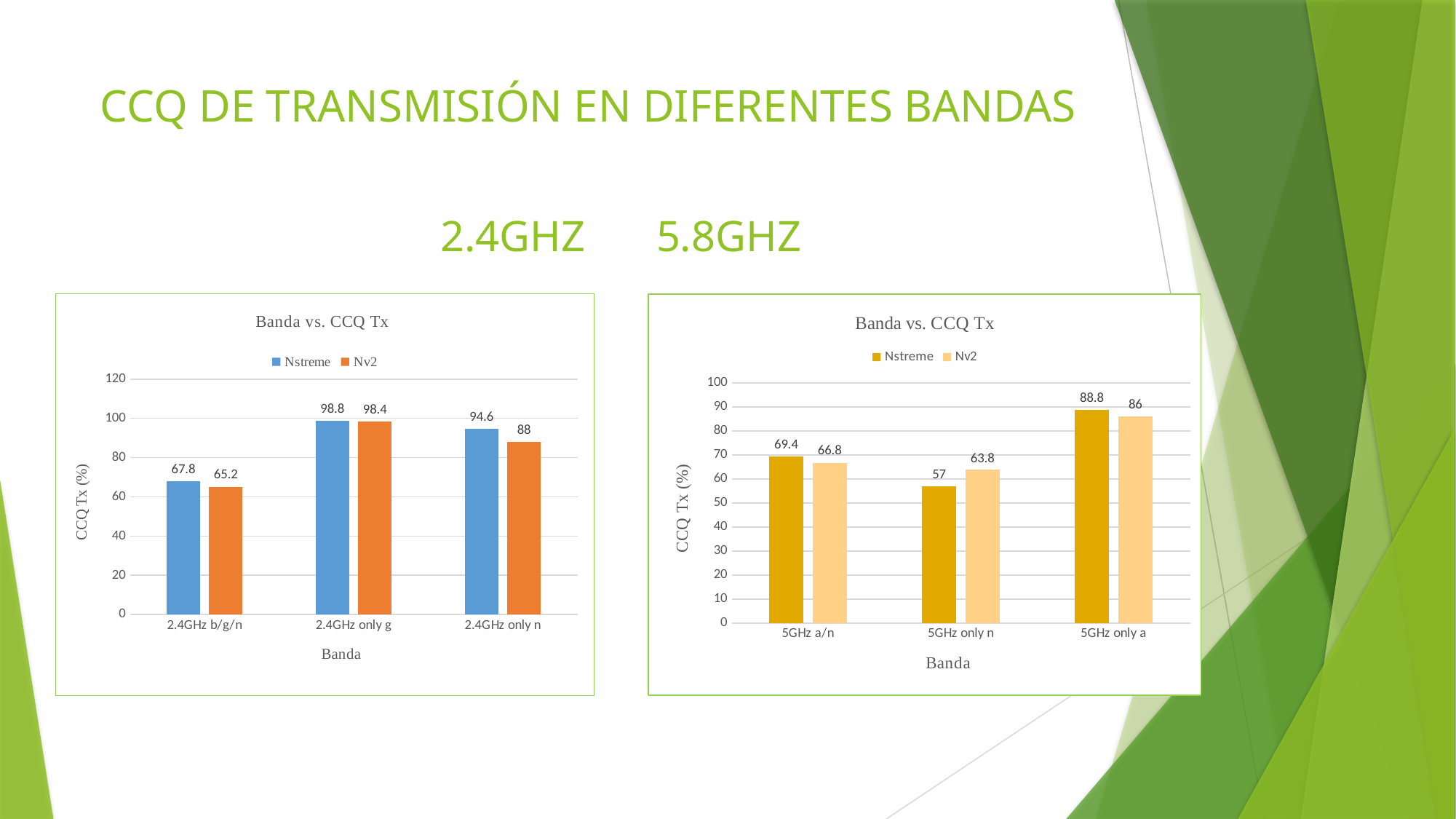
In the right chart (5.8GHz), which category has the highest Nstreme value? 5GHz only a What type of chart is the left chart (2.4GHz)? Bar chart In the left chart (2.4GHz), what is the difference between the Nstreme and Nv2 values for 2.4GHz only n? 6.6 In the right chart (5.8GHz), what is the difference between the Nstreme values for 5GHz only a and 5GHz only n? 31.8 In the left chart (2.4GHz), what is the Nstreme value for 2.4GHz only g? 98.8 In the right chart (5.8GHz), how many series does the legend list? 2 In the left chart (2.4GHz), what is the Nv2 value for 2.4GHz b/g/n? 65.2 In the right chart (5.8GHz), what is the Nv2 value for 5GHz only n? 63.8 In the right chart (5.8GHz), which is larger for 5GHz only n: Nstreme or Nv2? Nv2 What is the y-axis label of the right chart (5.8GHz)? CCQ Tx (%) In the left chart (2.4GHz), which category has the lowest Nv2 value? 2.4GHz b/g/n In the left chart (2.4GHz), how many categories are shown on the x axis? 3